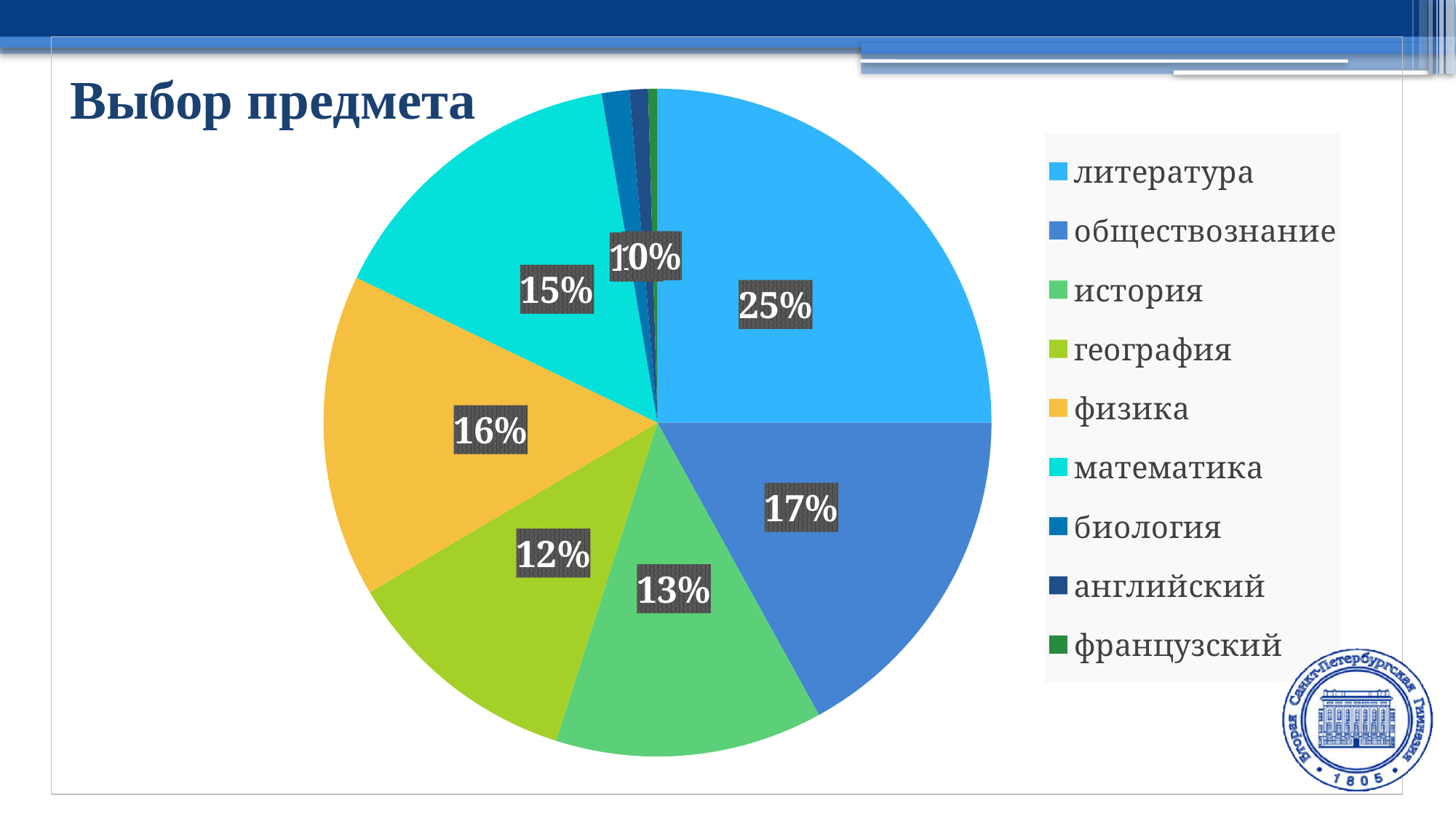
What is the difference between the shares of литература and обществознание? 8% Which subject has the largest share of the pie? литература What kind of chart is shown on the slide? pie chart What is the title of the chart? Выбор предмета What is the value for география? 12% What share of the pie does литература have? 25% What is the value for математика? 15% Which has a larger share, физика or математика? физика How many categories does the legend list? 9 What is the value for обществознание? 17% What is the value for физика? 16% What is the value for история? 13%